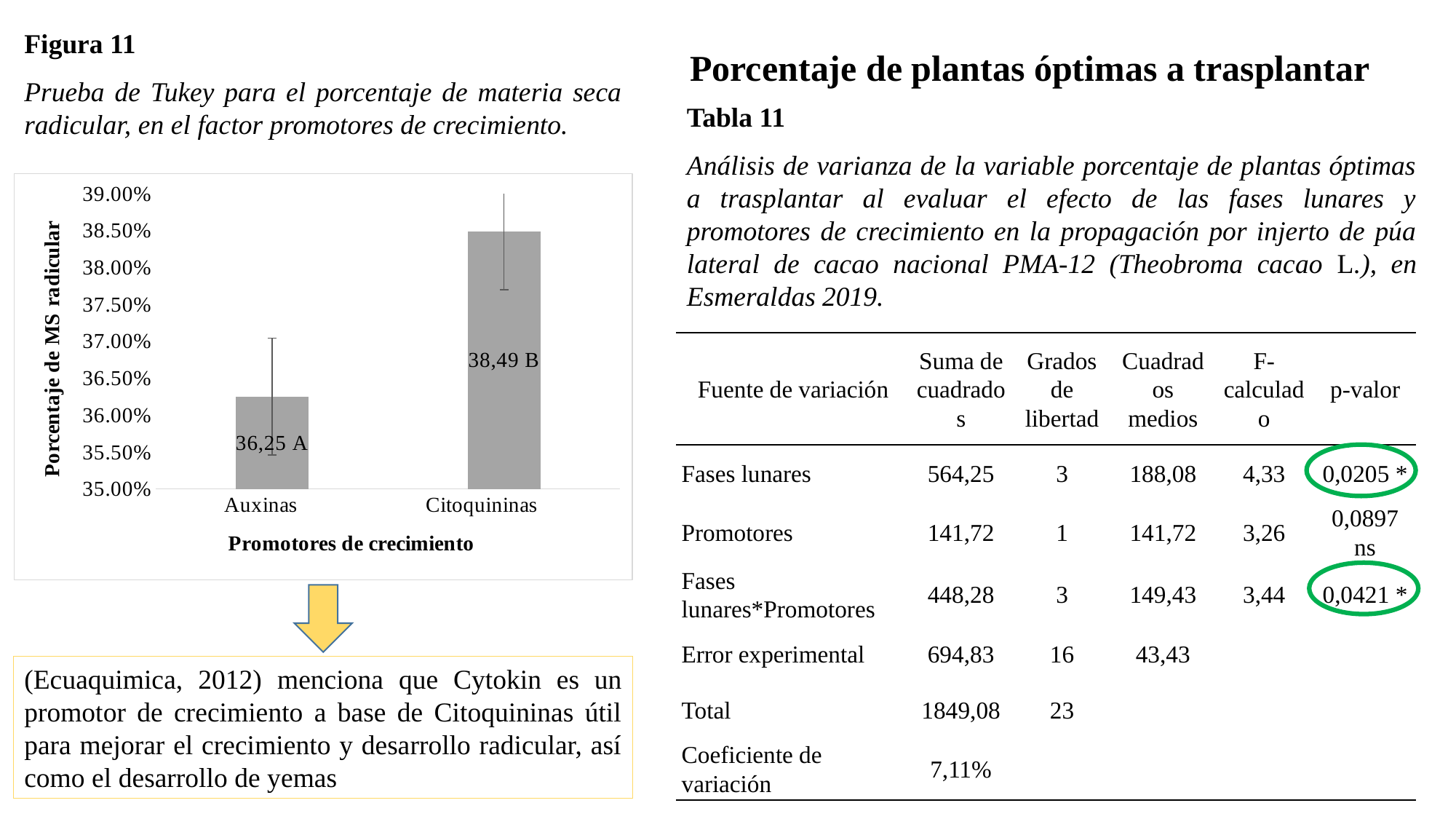
What value is labelled on the Auxinas bar in the chart? 36,25 What Tukey letter accompanies the data label on the Citoquininas bar? B How many categories are plotted on the x axis of the chart in Figura 11? 2 Is the value for Citoquininas in the chart greater or less than 38.00%? greater Which bar is taller in the chart, Auxinas or Citoquininas? Citoquininas What is the difference between the labelled values for Citoquininas and Auxinas in the chart? 2,24 What is the title of the y axis of the chart in Figura 11? Porcentaje de MS radicular What value is labelled on the Citoquininas bar in the chart? 38,49 Which growth promoter has the highest percentage of MS radicular in the chart? Citoquininas Is the value for Auxinas in the chart greater or less than 37.00%? less Which growth promoter has the lowest percentage of MS radicular in the chart? Auxinas What kind of chart is shown in Figura 11? bar chart